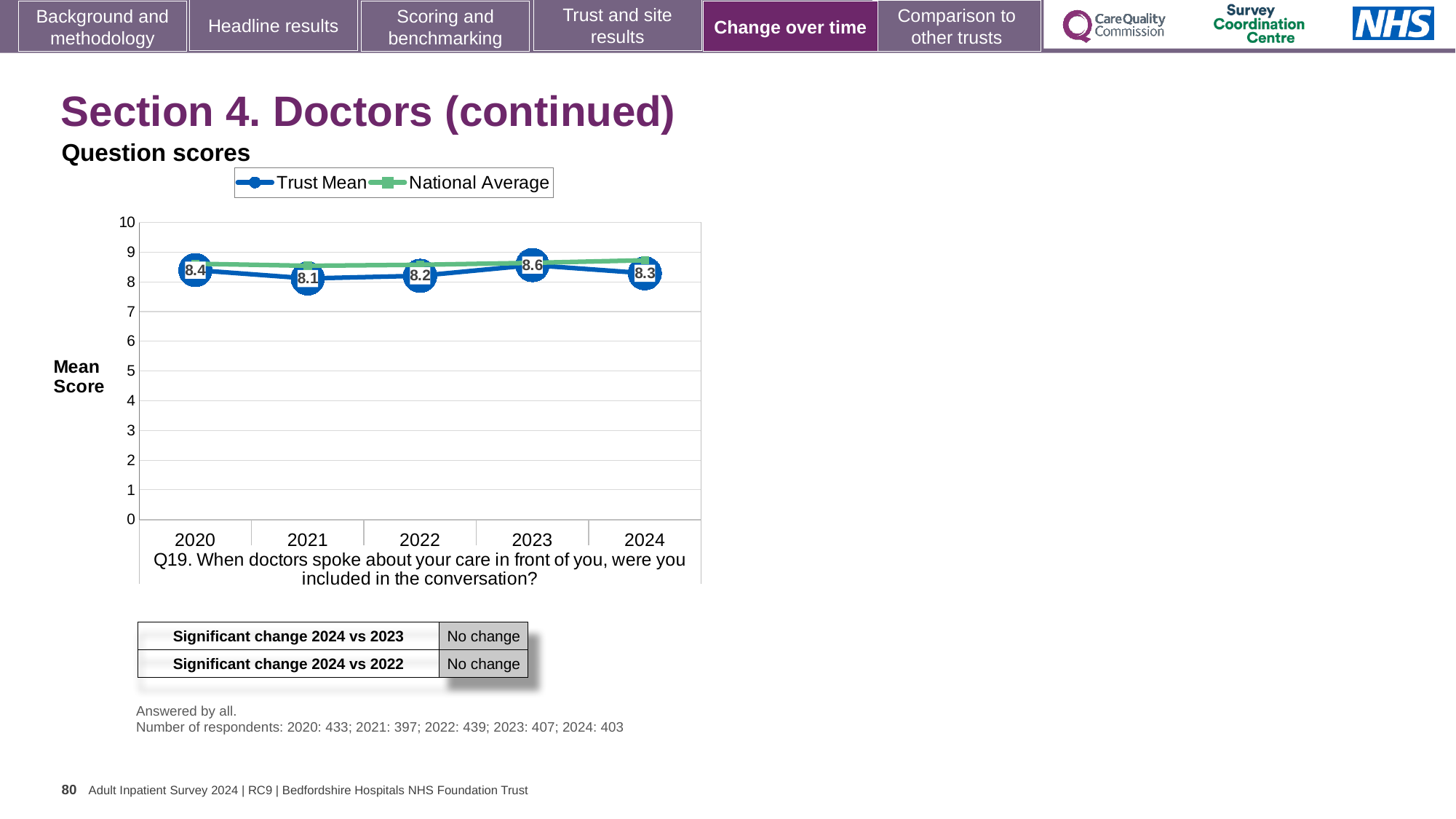
Which is larger, the Trust Mean score for 2020 or for 2024? 2020 In which year is the Trust Mean score lowest? 2021 What kind of chart is shown on the slide? Line chart What is the Trust Mean score for 2020? 8.4 What is the difference between the Trust Mean scores for 2023 and 2021? 0.5 What is the Trust Mean score for 2024? 8.3 What is the Trust Mean score for 2023? 8.6 Is the National Average value for 2024 greater or less than 8? greater In which year is the Trust Mean score highest? 2023 How many series does the legend list? 2 What is the Trust Mean score for 2021? 8.1 How many years are plotted on the x axis? 5